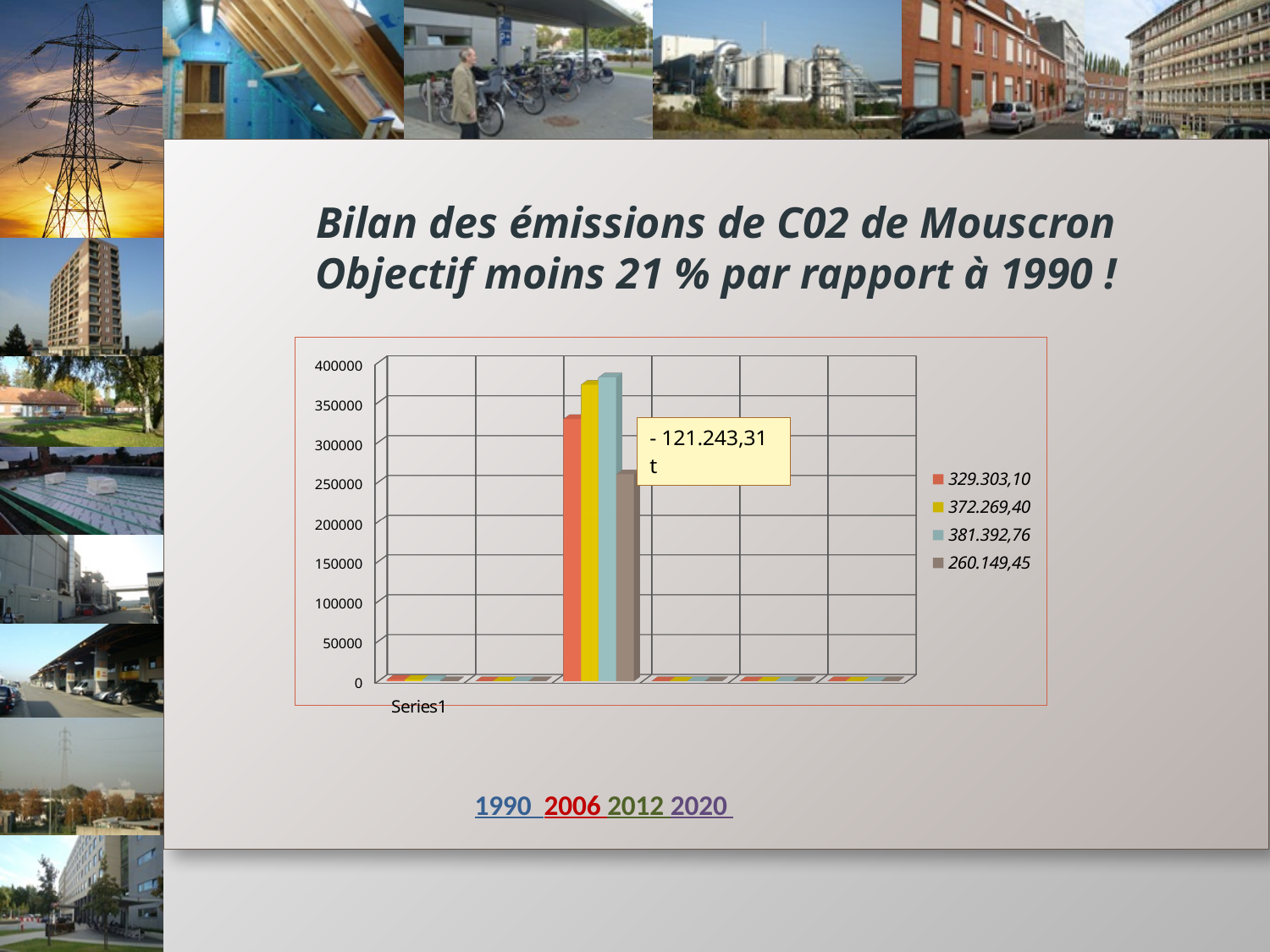
Is the value of the brown bar greater or less than 300000? less What is the lowest value listed in the chart legend? 260.149,45 What is the difference between the highest legend value (381.392,76) and the lowest legend value (260.149,45)? 121.243,31 What value does the legend give for the brown series? 260.149,45 What kind of chart is shown on the slide? bar chart How many series does the chart legend list? 4 What value is written in the text box placed over the chart? - 121.243,31 t Which is larger, the red series value or the brown series value? red series (329.303,10) What value does the legend give for the light blue series? 381.392,76 What is the difference between the yellow series value (372.269,40) and the red series value (329.303,10)? 42.966,30 What is the highest value listed in the chart legend? 381.392,76 Is the value of the yellow bar greater or less than 350000? greater